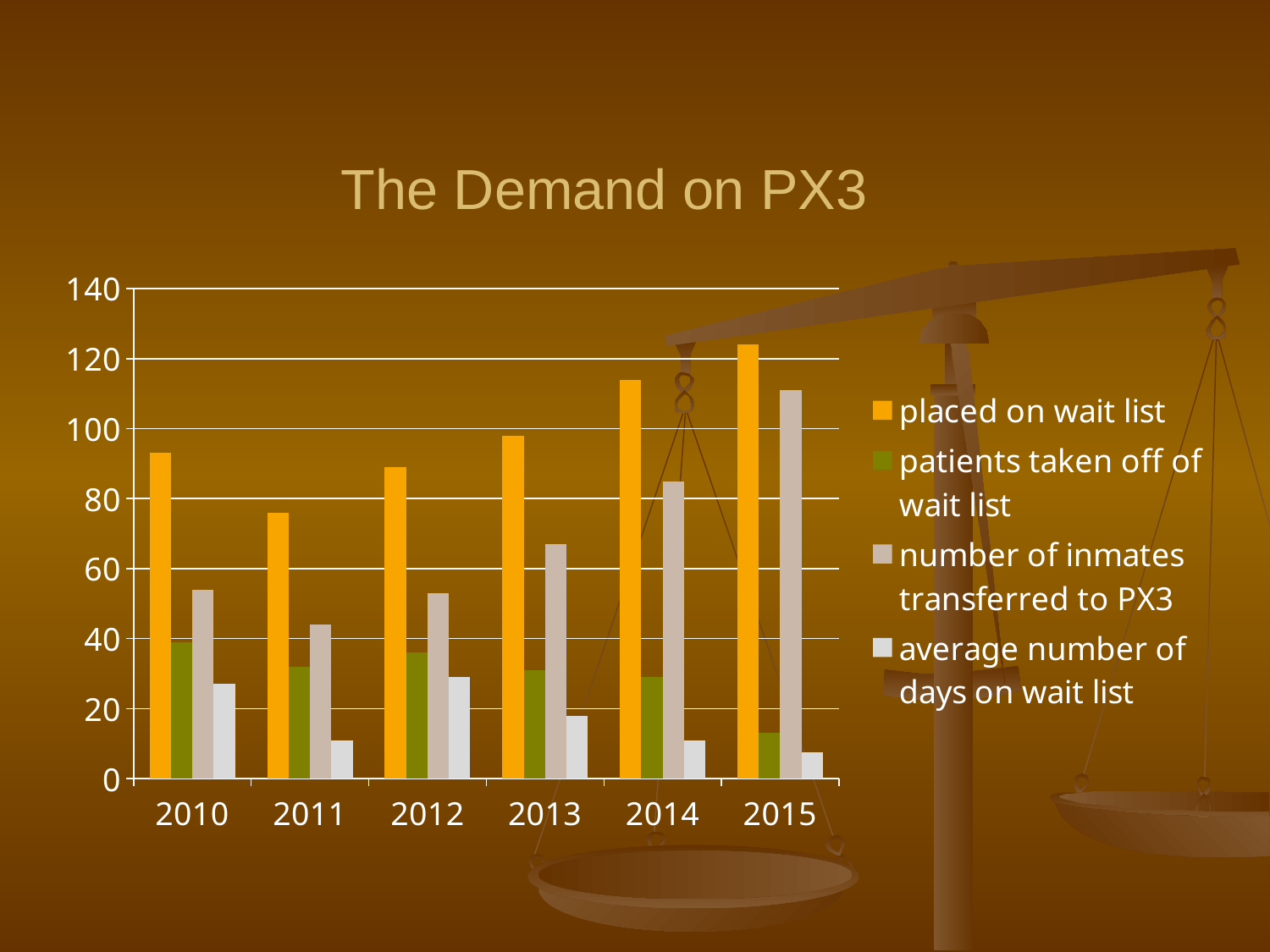
In which year is the value for 'number of inmates transferred to PX3' highest? 2015 Is the value for 'placed on wait list' in 2015 greater or less than 120? greater In which year is the value for 'placed on wait list' lowest? 2011 Is the value for 'patients taken off of wait list' in 2015 greater or less than 20? less What is the title of the chart? The Demand on PX3 How many series does the legend list? 4 In which year is the value for 'average number of days on wait list' lowest? 2015 Is the value for 'number of inmates transferred to PX3' in 2014 greater or less than 80? greater In which year is the value for 'placed on wait list' highest? 2015 How many years are shown on the x axis? 6 What kind of chart is shown on the slide? bar chart In 2010, which is larger: 'placed on wait list' or 'number of inmates transferred to PX3'? placed on wait list